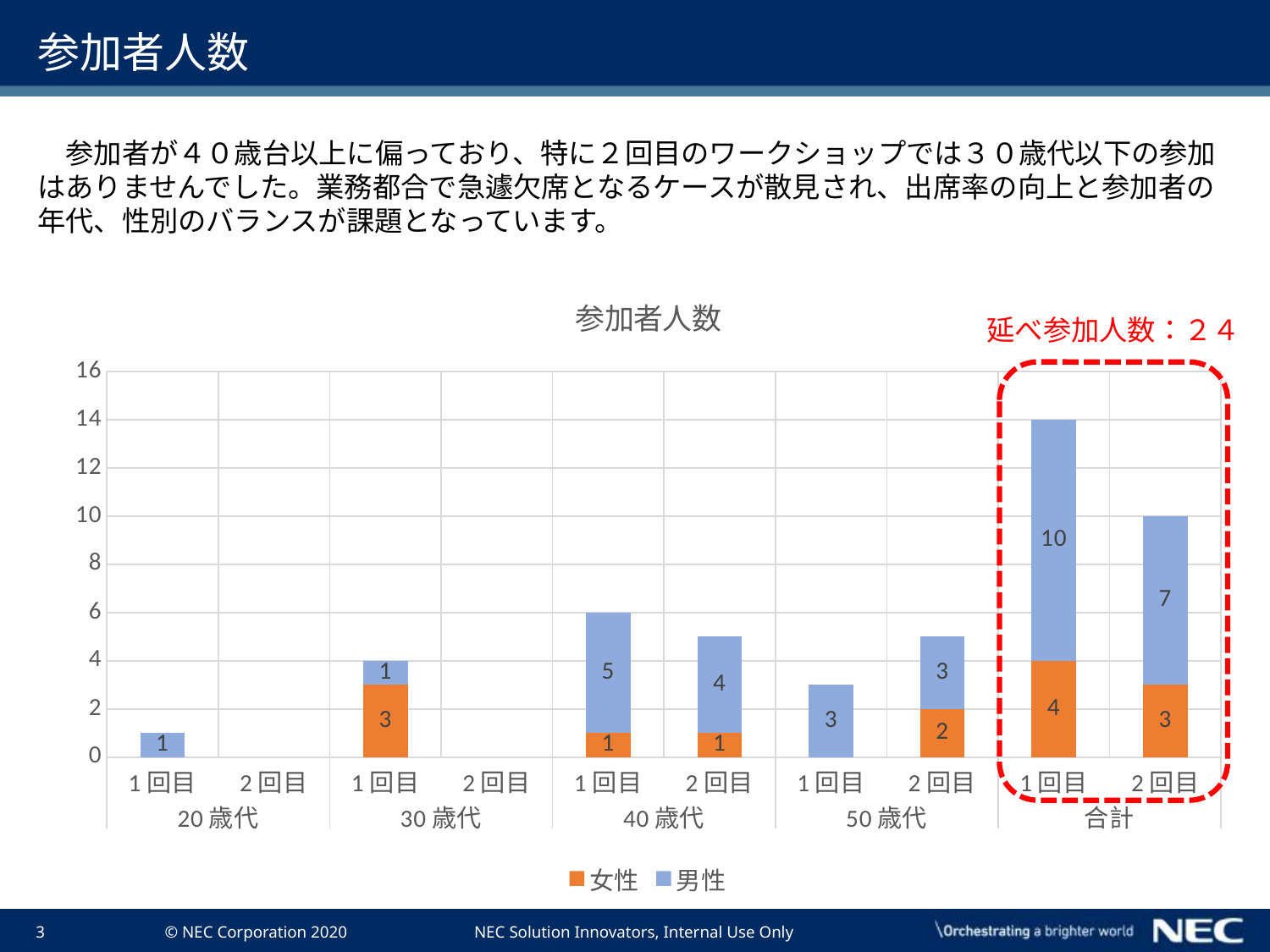
Which is larger, the 男性 value for 40歳代 1回目 or the 男性 value for 50歳代 1回目? 40歳代 1回目 What is the total of the stacked bar for 50歳代 2回目? 5 What is the 男性 value for 40歳代 1回目? 5 What is the 女性 value for 合計 2回目? 3 What is the 女性 value for 30歳代 1回目? 3 What is the 延べ参加人数 shown in red text on the slide? 24 What is the difference between the 男性 values for 合計 1回目 and 合計 2回目? 3 How many series does the chart legend list? 2 What is the total of the stacked bar for 合計 1回目? 14 Is the total for 合計 1回目 greater or less than 12? greater What kind of chart is shown on the slide? Stacked bar chart What is the 男性 value for 合計 1回目? 10